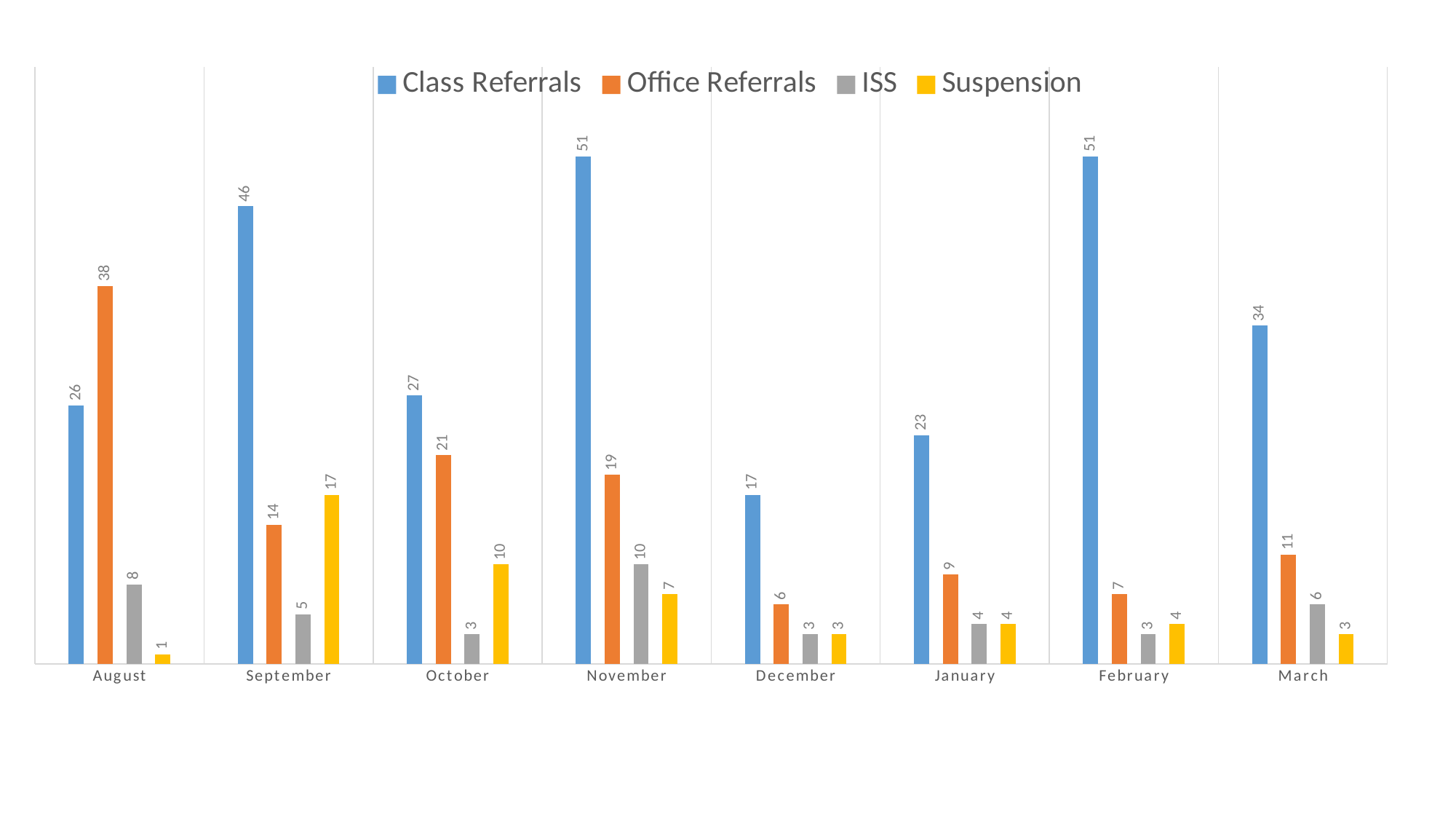
Which month has the highest Office Referrals value? August What is the value of Office Referrals for August? 38 What is the value of Suspension for November? 7 How many series does the legend list? 4 What is the value of ISS for March? 6 How many months are shown on the x axis? 8 What is the difference between Class Referrals and Office Referrals in October? 6 What kind of chart is shown on the slide? Bar chart What is the value of Class Referrals for September? 46 Which month has the lowest Class Referrals value? December Which is larger in August: Class Referrals or Office Referrals? Office Referrals Which month has the highest Suspension value? September